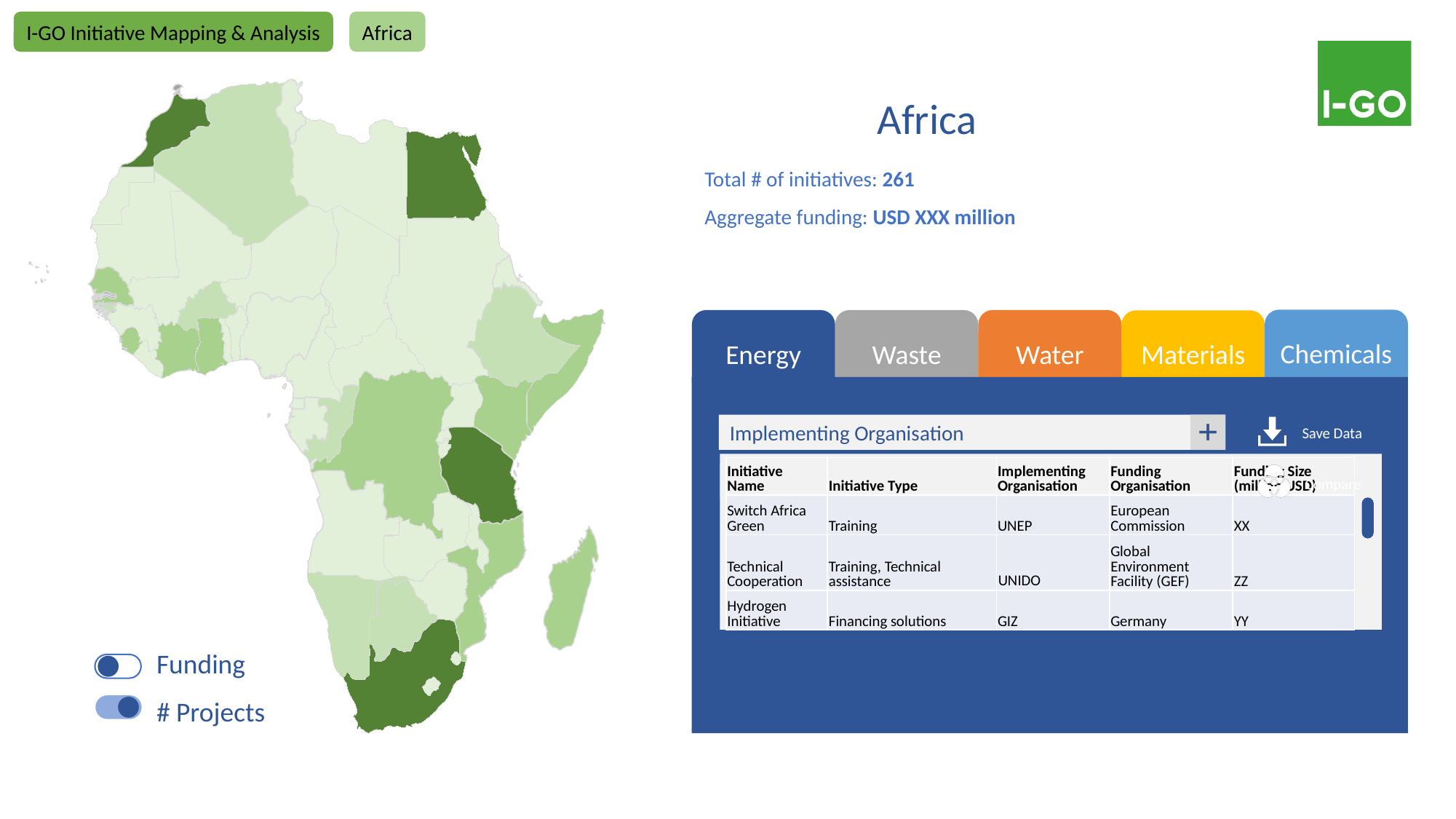
In the table on the right, which organisation implements the Switch Africa Green initiative? UNEP In the table on the right, which organisation funds the Hydrogen Initiative? Germany In the table on the right, which organisation implements the Technical Cooperation initiative? UNIDO What region does the map chart on the slide show? Africa What kind of chart is shown on the left side of the slide? map In the table on the right, what is the initiative type of the Hydrogen Initiative? Financing solutions On the map chart, which of the two toggles below the map is switched on? # Projects In the table on the right, how many initiatives are listed? 3